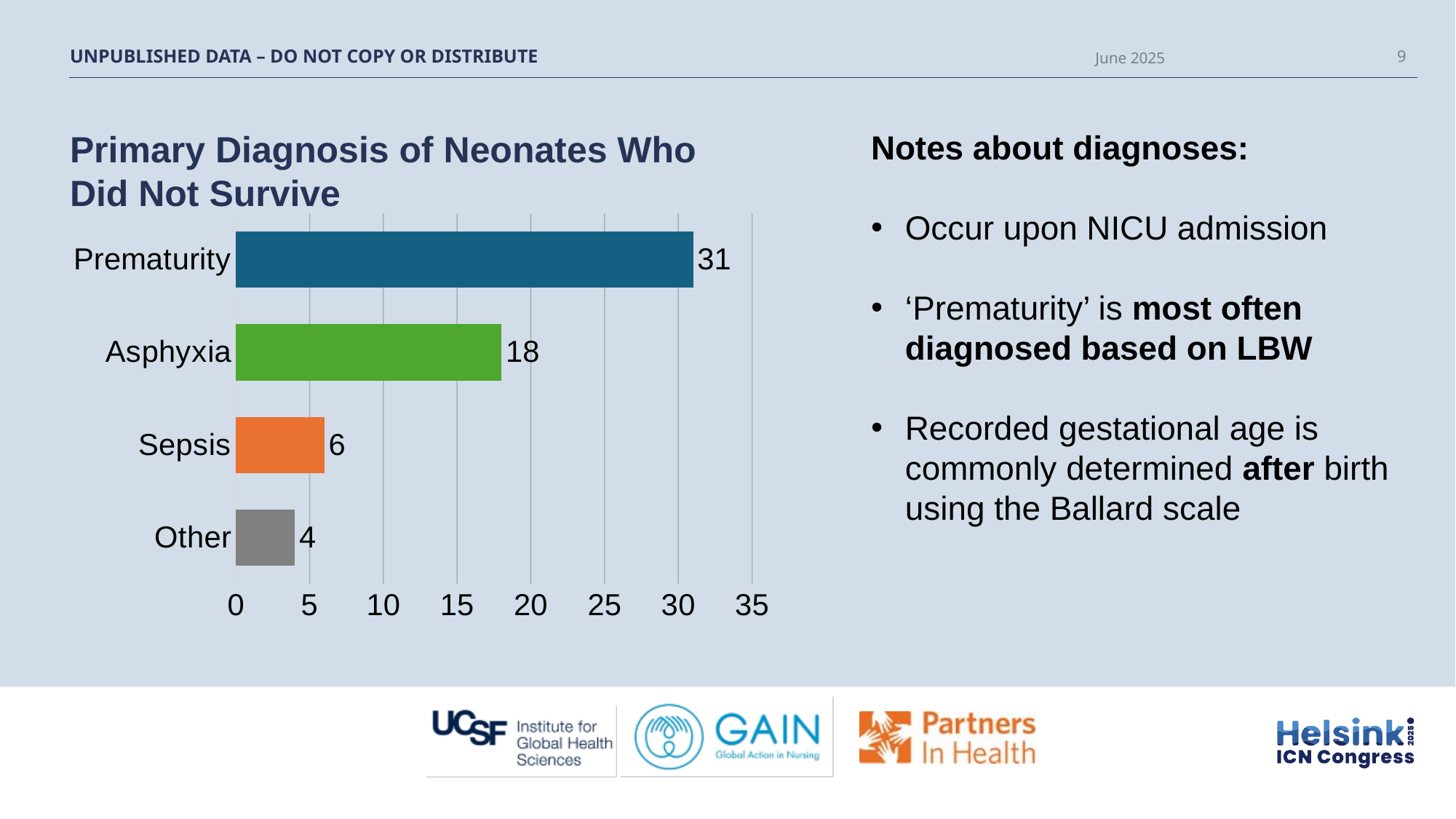
What is the value for Other? 4 What is the value for Prematurity? 31 How many diagnosis categories are shown in the chart? 4 Which diagnosis has the lowest value? Other What is the value for Asphyxia? 18 Which is larger, the value for Asphyxia or the value for Sepsis? Asphyxia What kind of chart is shown on the slide? Bar chart What is the difference between the values for Prematurity and Asphyxia? 13 What is the value for Sepsis? 6 What is the difference between the values for Sepsis and Other? 2 Which diagnosis has the highest value? Prematurity What is the title of the chart? Primary Diagnosis of Neonates Who Did Not Survive